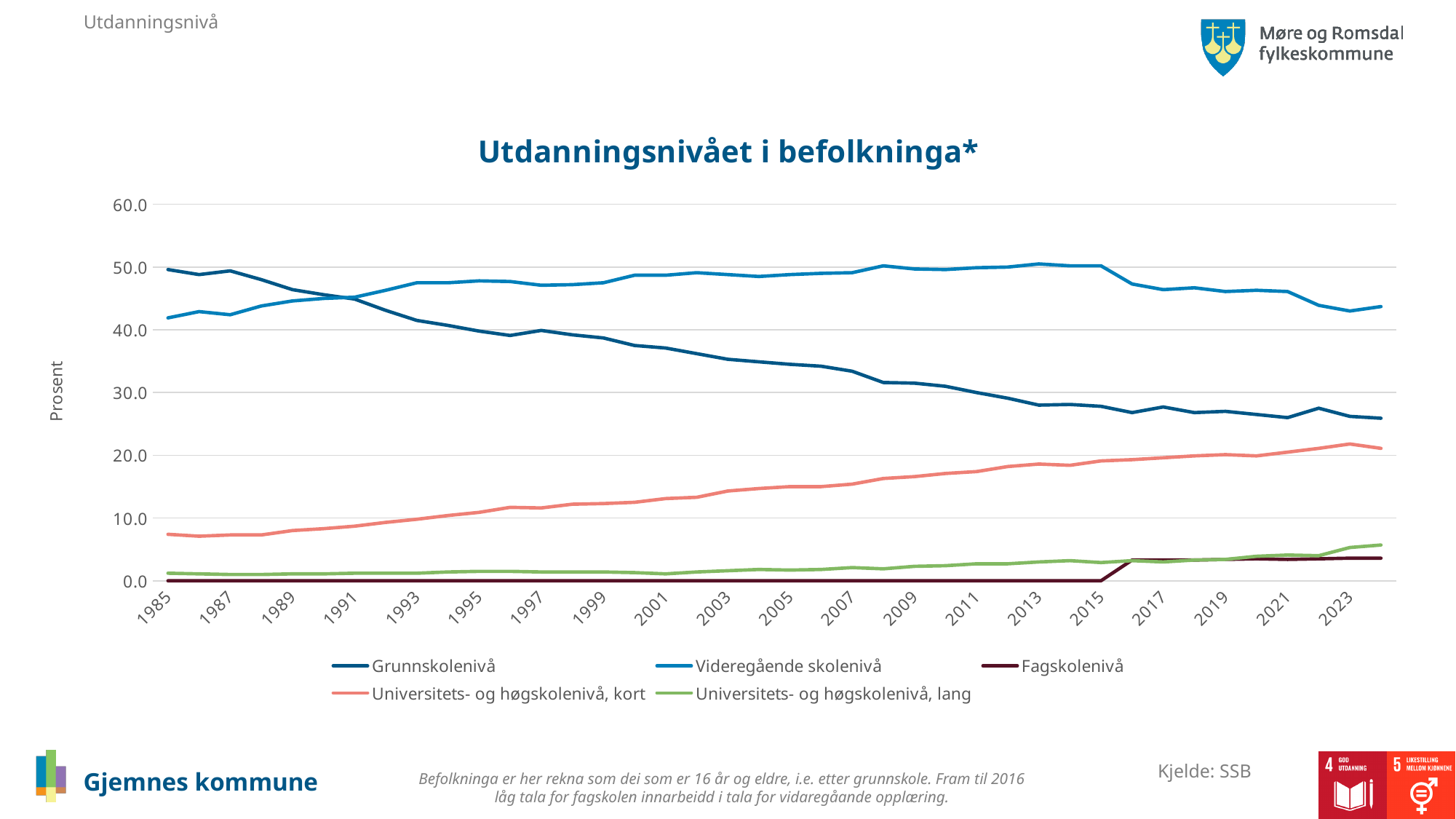
What kind of chart is shown on the slide? line chart Is the value for Grunnskolenivå in 1985 greater or less than 40.0? greater Is the value for Videregående skolenivå in 2023 greater or less than 50.0? less What is the title of the chart? Utdanningsnivået i befolkninga* In 2023, which is higher: Grunnskolenivå or Videregående skolenivå? Videregående skolenivå How many series does the legend list? 5 Does the Universitets- og høgskolenivå, kort line rise or fall from 1985 to 2023? rise Is the value for Fagskolenivå in 2023 greater or less than 10.0? less What is the label on the vertical axis? Prosent Which series has the lowest value in 1985? Fagskolenivå Does the Grunnskolenivå line rise or fall from 1985 to 2023? fall